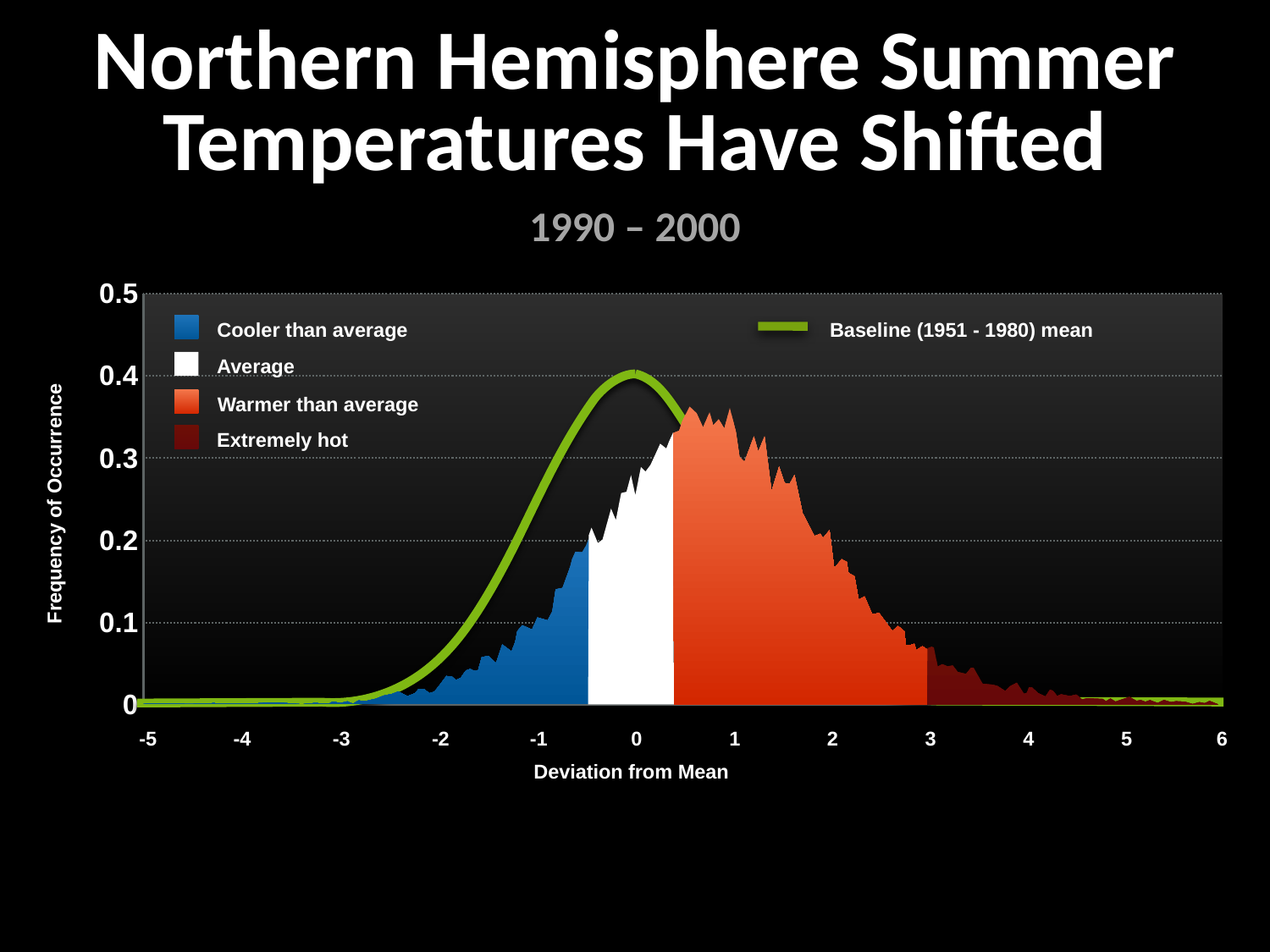
How many entries does the chart's legend list? 5 What is the title of the chart on the slide? Northern Hemisphere Summer Temperatures Have Shifted At a deviation from mean of 3, is the frequency of occurrence for 1990 – 2000 greater or less than 0.1? less Is the highest value of the 1990 – 2000 distribution greater or less than 0.3? greater Between a deviation from mean of 1 and 4, do the 1990 – 2000 frequency values rise or fall? fall Is the peak value of the Baseline (1951 - 1980) mean curve greater or less than 0.5? less What is the label of the y axis? Frequency of Occurrence At what deviation from mean does the Baseline (1951 - 1980) mean curve reach its peak? 0 What kind of chart is shown on the slide? Area chart with a line overlay